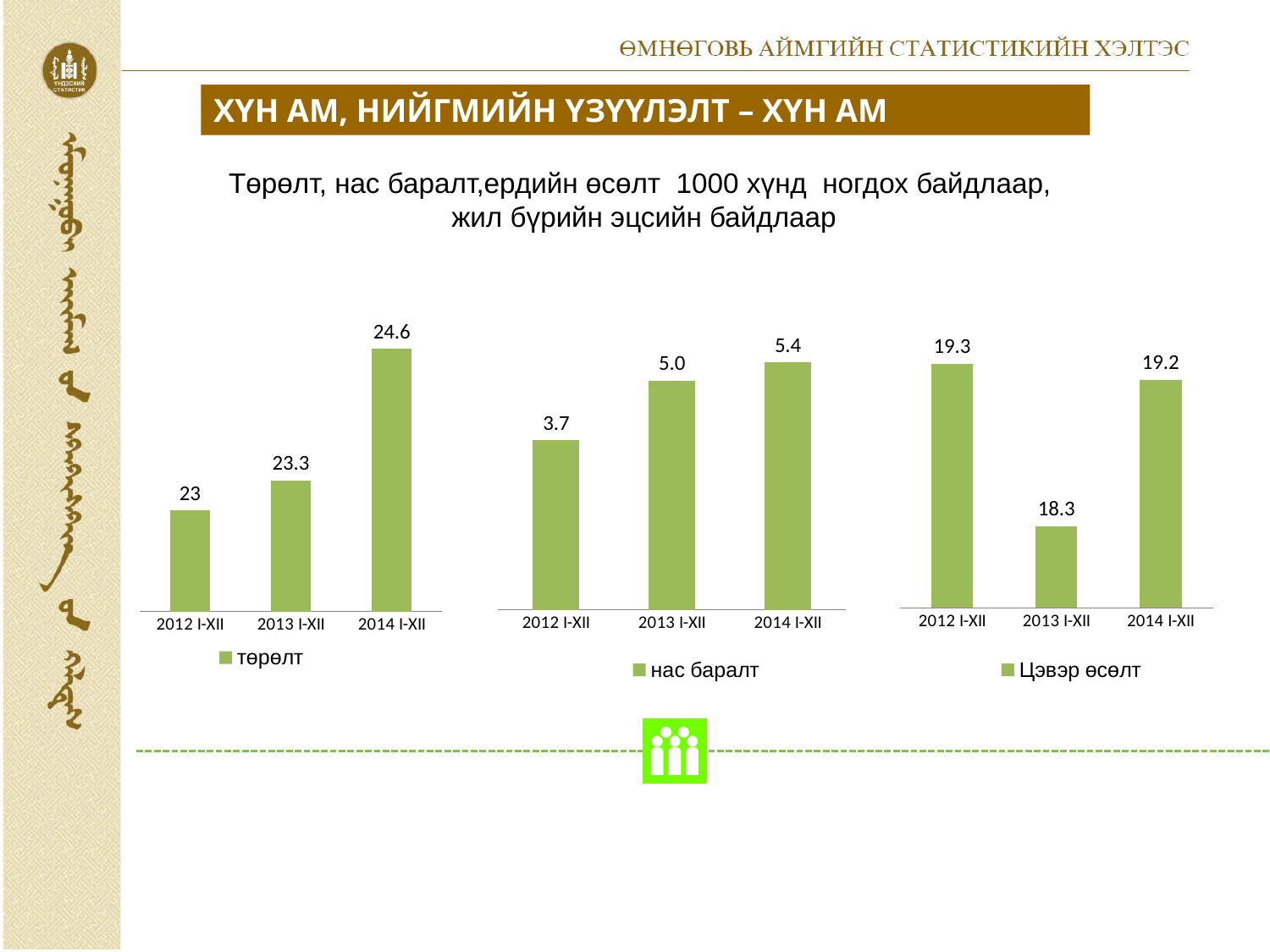
Do the values in the middle chart (legend "нас баралт") rise or fall from 2012 I-XII to 2014 I-XII? rise In the right chart (legend "Цэвэр өсөлт"), is the value for 2012 I-XII larger or smaller than the value for 2013 I-XII? larger In the middle chart (legend "нас баралт"), which period has the highest value? 2014 I-XII In the middle chart (legend "нас баралт"), what is the difference between the 2013 I-XII and 2012 I-XII values? 1.3 What type of chart is the left chart (legend "төрөлт")? bar chart In the left chart (legend "төрөлт"), which period has the lowest value? 2012 I-XII How many periods are shown on the x axis of the middle chart (legend "нас баралт")? 3 In the right chart (legend "Цэвэр өсөлт"), what is the value for 2013 I-XII? 18.3 In the middle chart (legend "нас баралт"), what is the value for 2012 I-XII? 3.7 In the left chart (legend "төрөлт"), what is the difference between the 2014 I-XII and 2012 I-XII values? 1.6 In the right chart (legend "Цэвэр өсөлт"), which period has the lowest value? 2013 I-XII In the left chart (legend "төрөлт"), what is the value for 2014 I-XII? 24.6